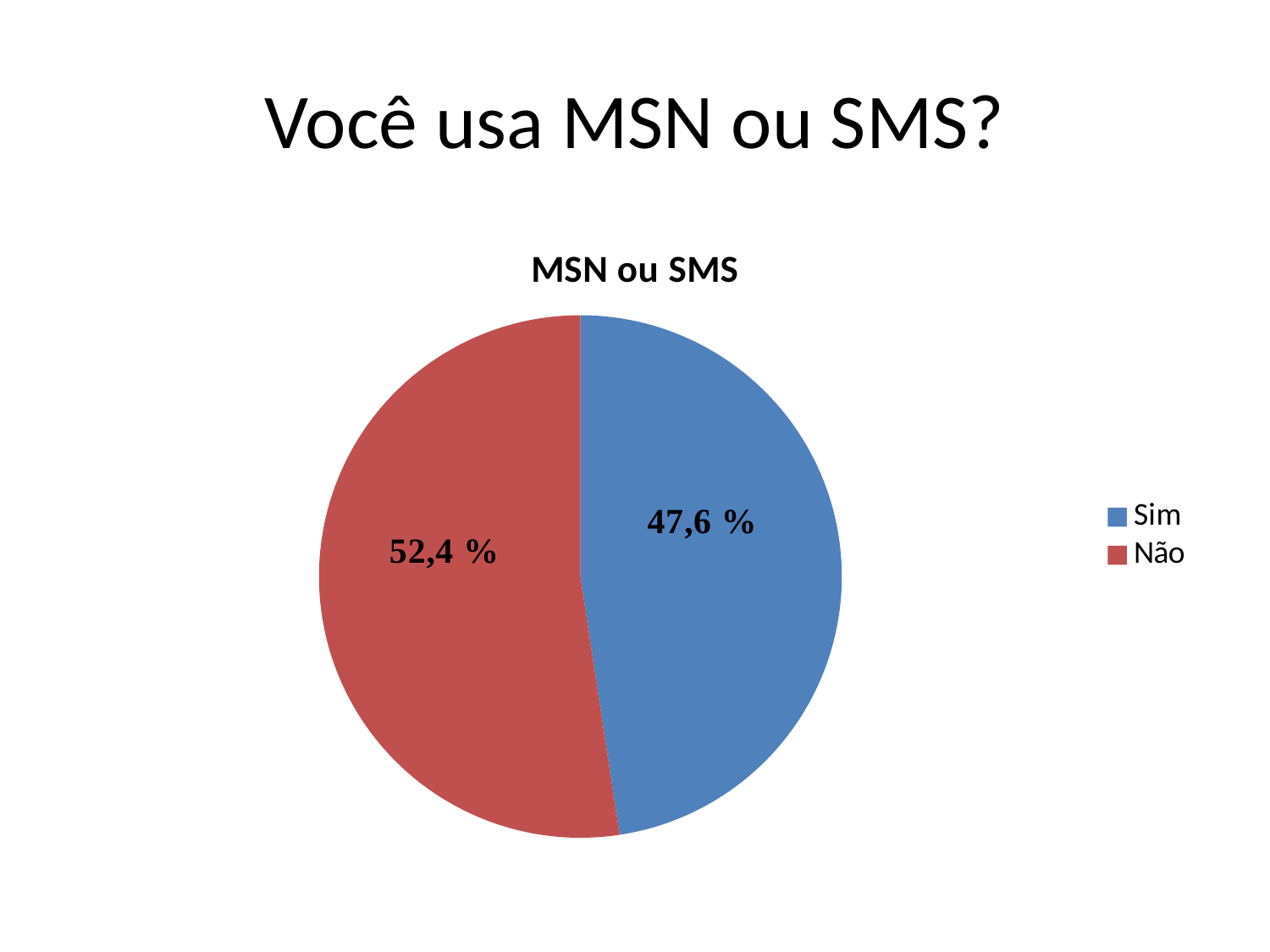
Which is larger, the "Sim" slice or the "Não" slice? Não Which slice is the smallest? Sim What is the chart's title? MSN ou SMS How many slices does the pie chart have? 2 Which slice is the largest? Não How many entries does the legend list? 2 What is the difference in percentage points between the "Não" and "Sim" slices? 4,8 What share of the pie does the "Não" slice represent? 52,4 % What share of the pie does the "Sim" slice represent? 47,6 % What kind of chart is shown on the slide? pie chart What colour is the "Sim" slice? blue